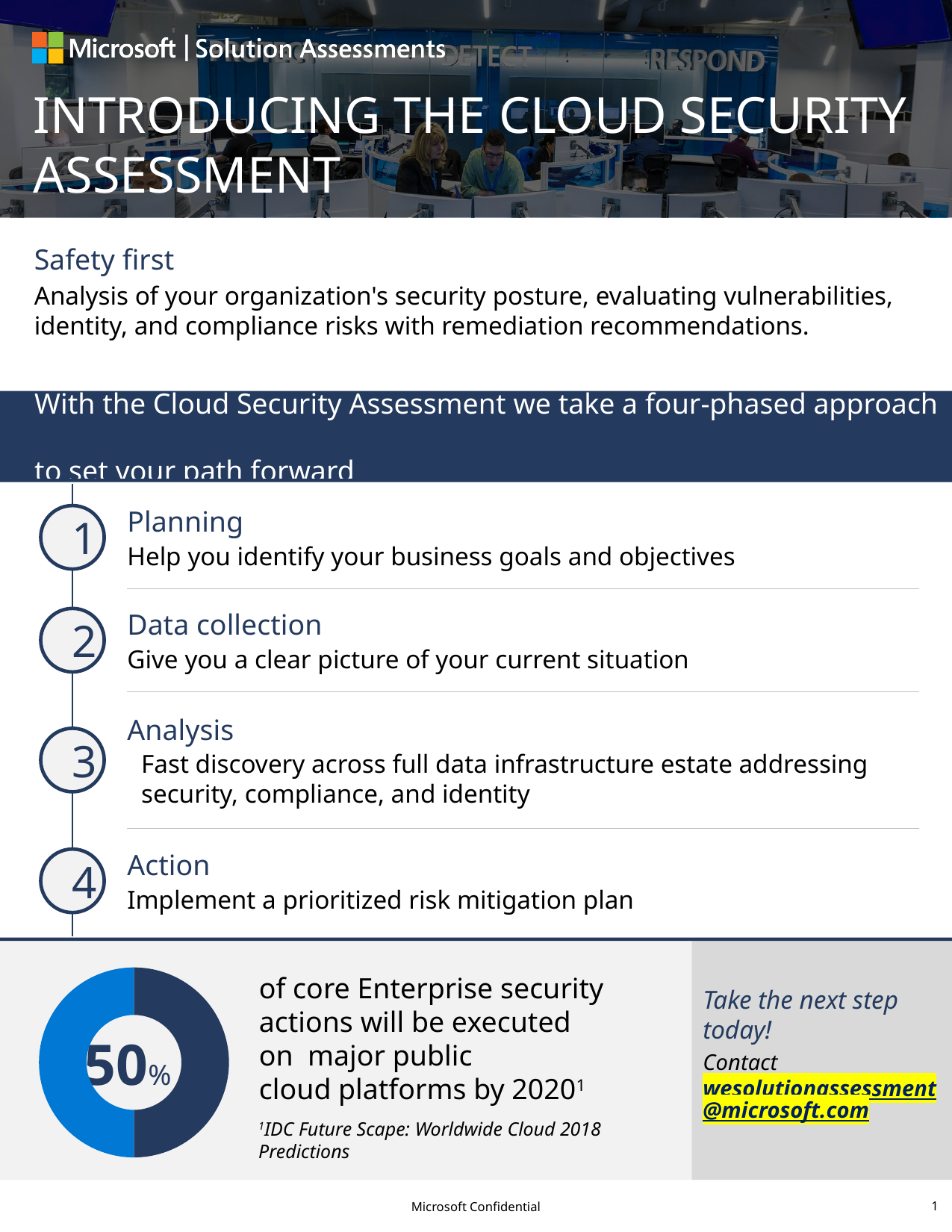
According to the doughnut chart, what share of core Enterprise security actions will be executed on major public cloud platforms by 2020? 50% Is the value highlighted in the doughnut chart greater or less than 40%? greater What two colours are used for the slices of the doughnut chart? light blue and dark blue What kind of chart is shown at the bottom left of the slide? doughnut chart What percentage is printed in the centre of the doughnut chart? 50% How many slices does the doughnut chart have? 2 What source is cited beneath the doughnut chart's statement? IDC Future Scape: Worldwide Cloud 2018 Predictions